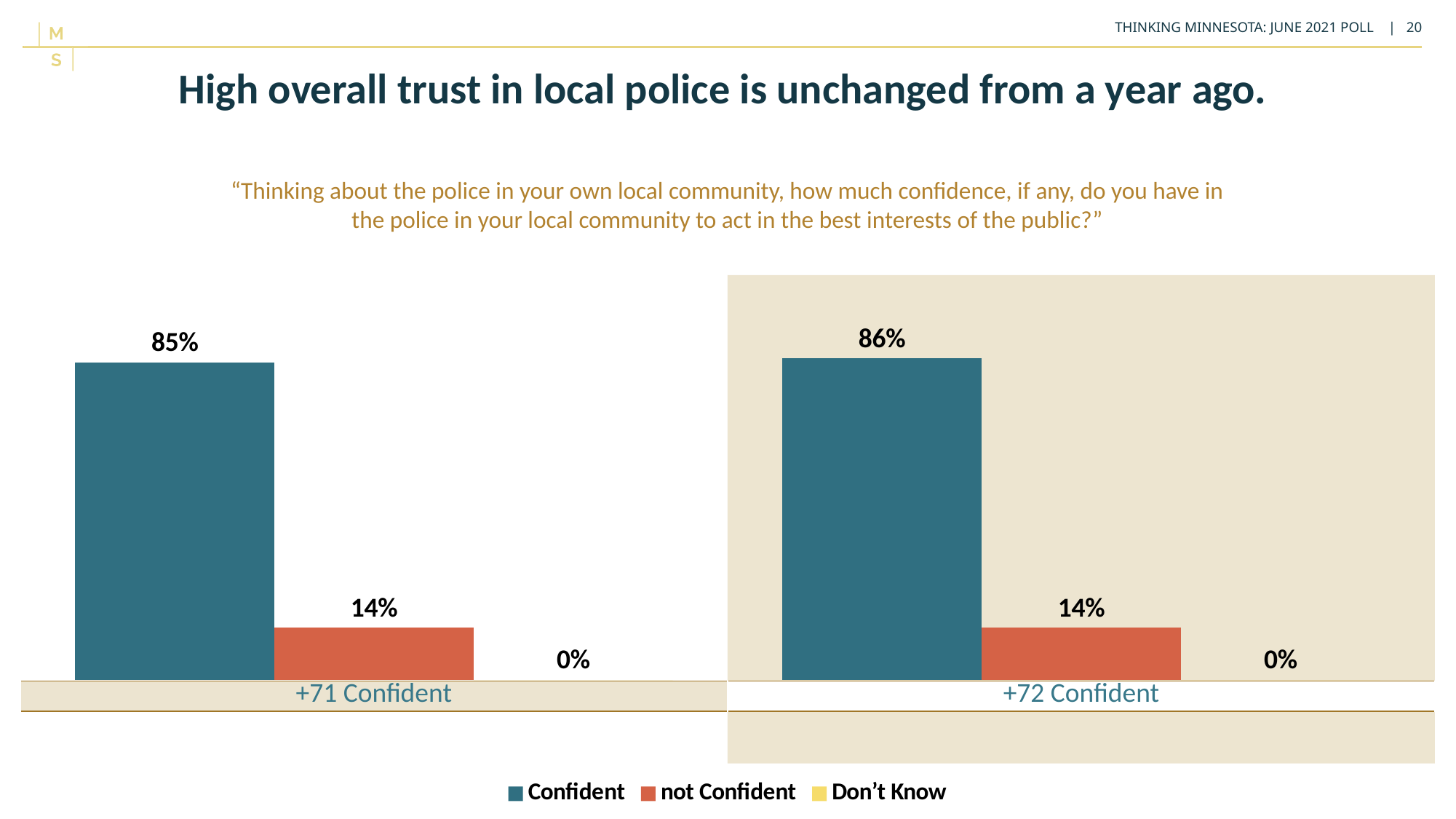
What is the difference between Confident and not Confident in the left group of bars? 71 What is the value for Don't Know in the right group of bars? 0% Which is larger: Confident in the left group or not Confident in the left group? Confident in the left group What colour are the Confident bars? teal Which series has the highest value in the right group of bars? Confident What is the value for Confident in the left group of bars? 85% Which series has the lowest value in the left group of bars? Don't Know What is the value for not Confident in the left group of bars? 14% What is the difference between Confident and not Confident in the right group of bars? 72 What kind of chart is shown on the slide? bar chart How many series does the legend list? 3 What is the value for Confident in the right group of bars? 86%